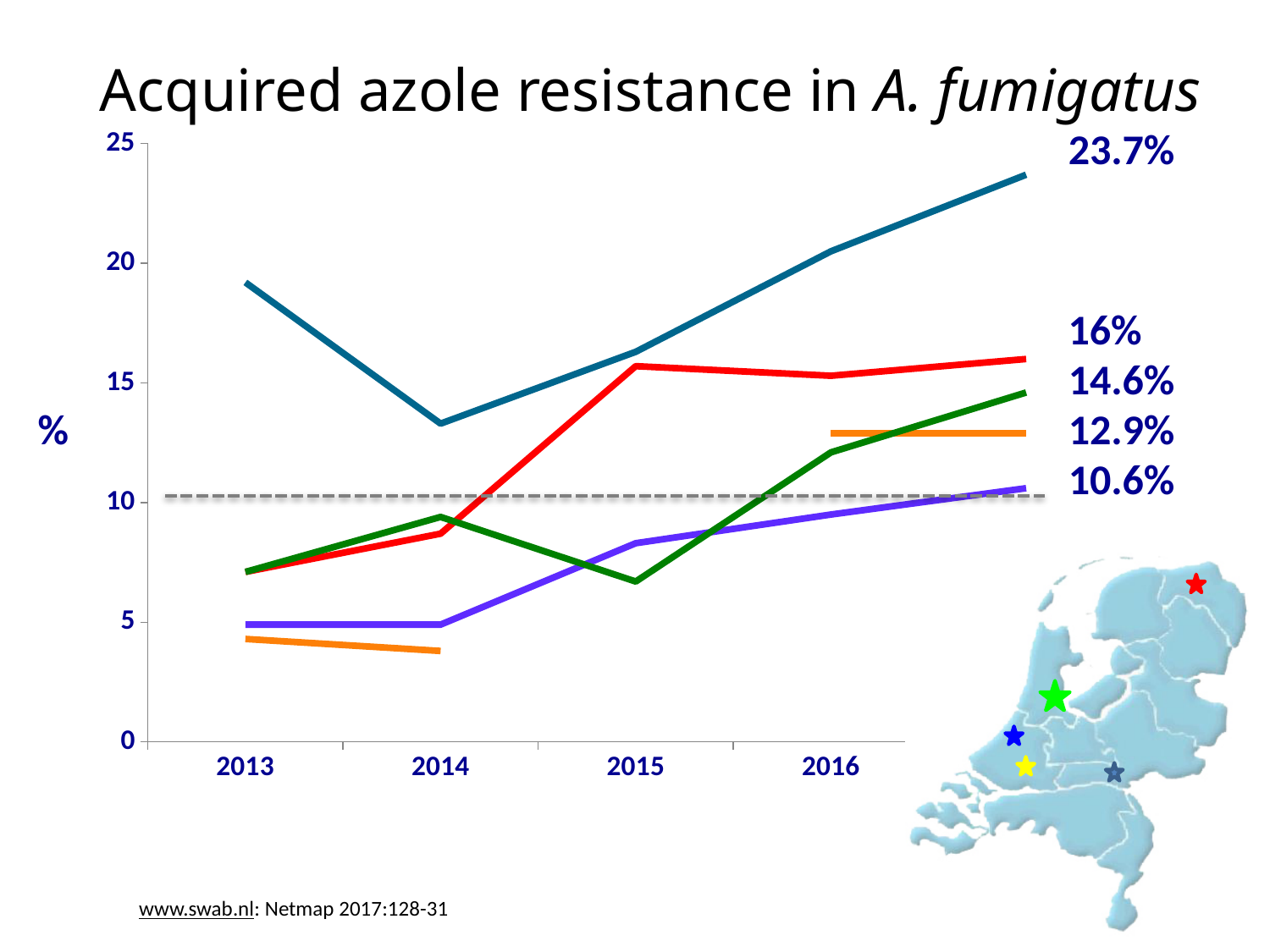
Does the purple line rise or fall from 2014 to 2016? rise How many years are labelled on the x axis of the chart? 4 What is the label on the y axis of the chart? % Which of the labelled final values is the lowest? 10.6% Which of the labelled final values is the highest? 23.7% What is the title of the chart? Acquired azole resistance in A. fumigatus What is the final value labelled for the red line? 16% What is the final value labelled for the teal (dark blue-green) line? 23.7% What kind of chart is shown on the slide? line chart What is the difference between the labelled final values of the teal line (23.7%) and the red line (16%)? 7.7 percentage points What is the final value labelled for the purple line? 10.6% Is the value of the teal line in 2013 greater or less than 15? greater